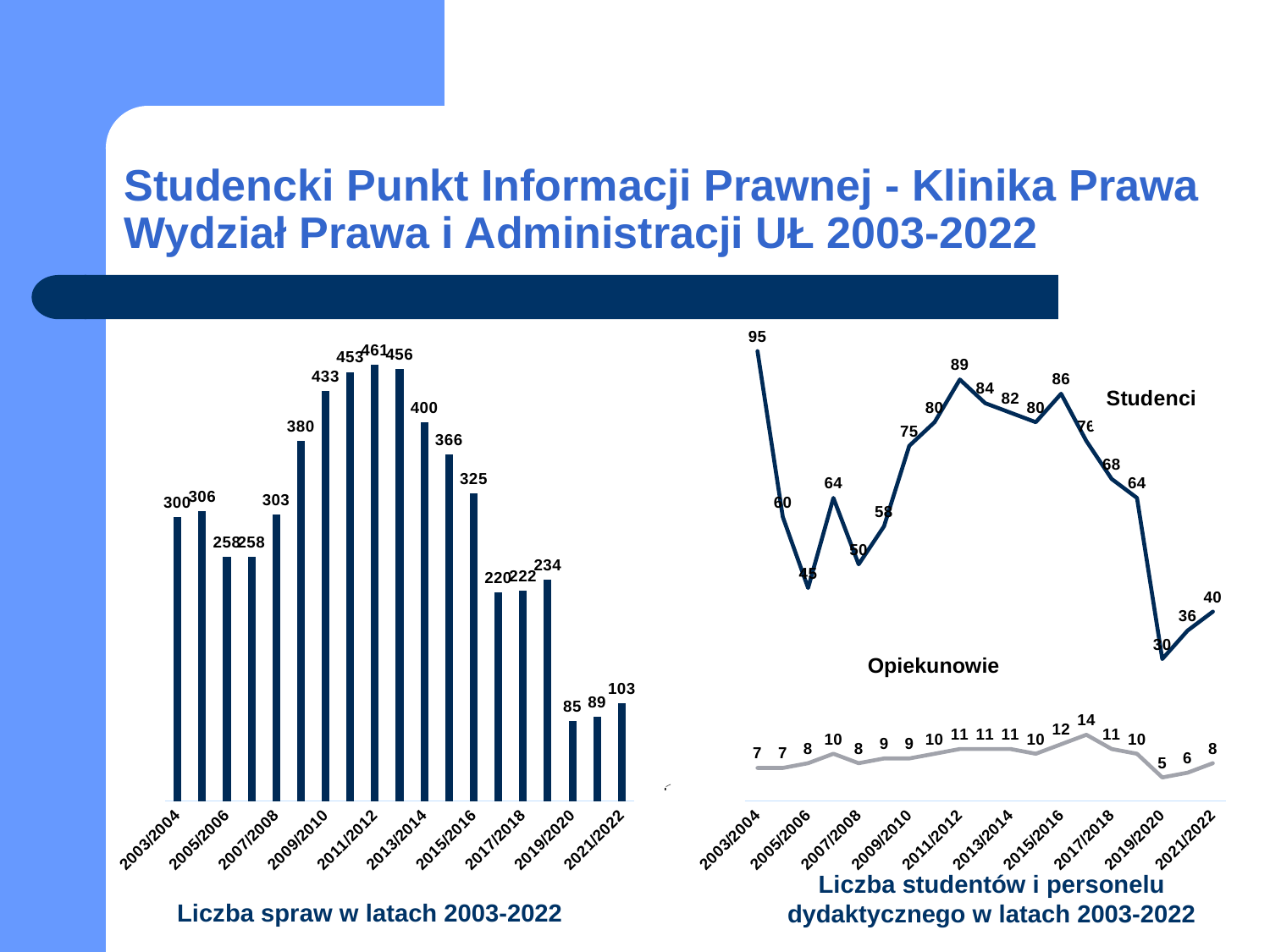
In the chart 'Liczba studentów i personelu dydaktycznego w latach 2003-2022', what is the difference between the Studenci value for 2003/2004 and for 2021/2022? 55 In the chart 'Liczba spraw w latach 2003-2022', which is larger: the value for 2003/2004 or the value for 2007/2008? 2007/2008 In the chart 'Liczba spraw w latach 2003-2022', what is the value for 2019/2020? 85 In the chart 'Liczba spraw w latach 2003-2022', which year has the lowest value? 2019/2020 In the chart 'Liczba studentów i personelu dydaktycznego w latach 2003-2022', in which year is the Opiekunowie value highest? 2016/2017 In the chart 'Liczba spraw w latach 2003-2022', which year has the highest value? 2011/2012 In the chart 'Liczba studentów i personelu dydaktycznego w latach 2003-2022', what is the Studenci value for 2003/2004? 95 In the chart 'Liczba spraw w latach 2003-2022', what is the value for 2011/2012? 461 In the chart 'Liczba studentów i personelu dydaktycznego w latach 2003-2022', what is the Opiekunowie value for 2021/2022? 8 In the chart 'Liczba spraw w latach 2003-2022', what is the difference between the values for 2009/2010 and 2013/2014? 33 How many series are plotted in the chart 'Liczba studentów i personelu dydaktycznego w latach 2003-2022'? 2 What type of chart is 'Liczba spraw w latach 2003-2022'? bar chart